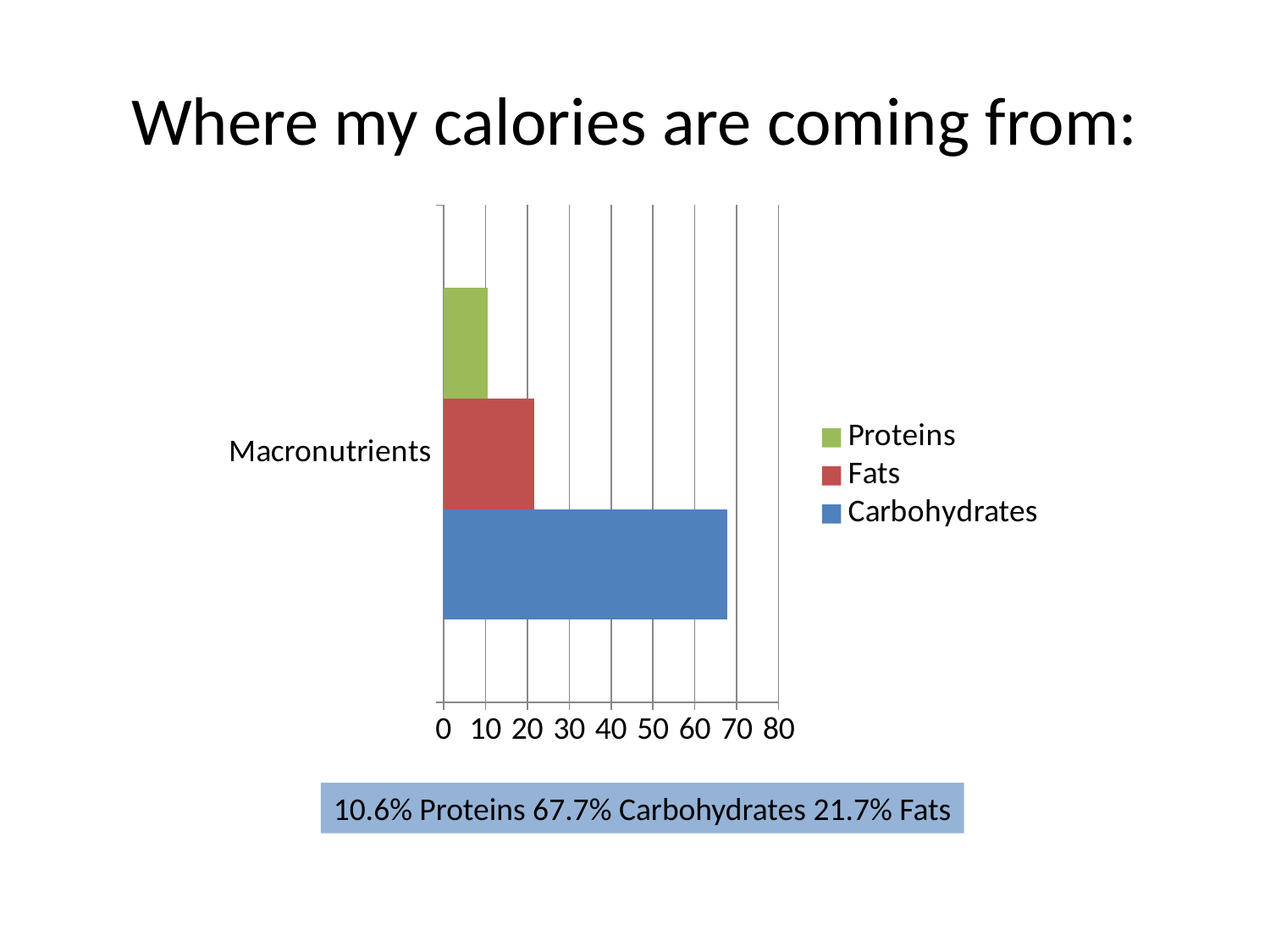
How many series does the legend list? 3 Which series has the highest value for Macronutrients? Carbohydrates How many categories are shown on the vertical axis of the chart? 1 What is the difference between the Carbohydrates and Fats percentages? 46.0% Is the value for Carbohydrates greater or less than 60? greater Which colour represents Carbohydrates in the chart? Blue What kind of chart is shown on the slide? Bar chart What percentage of calories comes from Proteins? 10.6% Which is larger, the value for Fats or the value for Proteins? Fats Which series has the lowest value for Macronutrients? Proteins What percentage of calories comes from Carbohydrates? 67.7% What percentage of calories comes from Fats? 21.7%